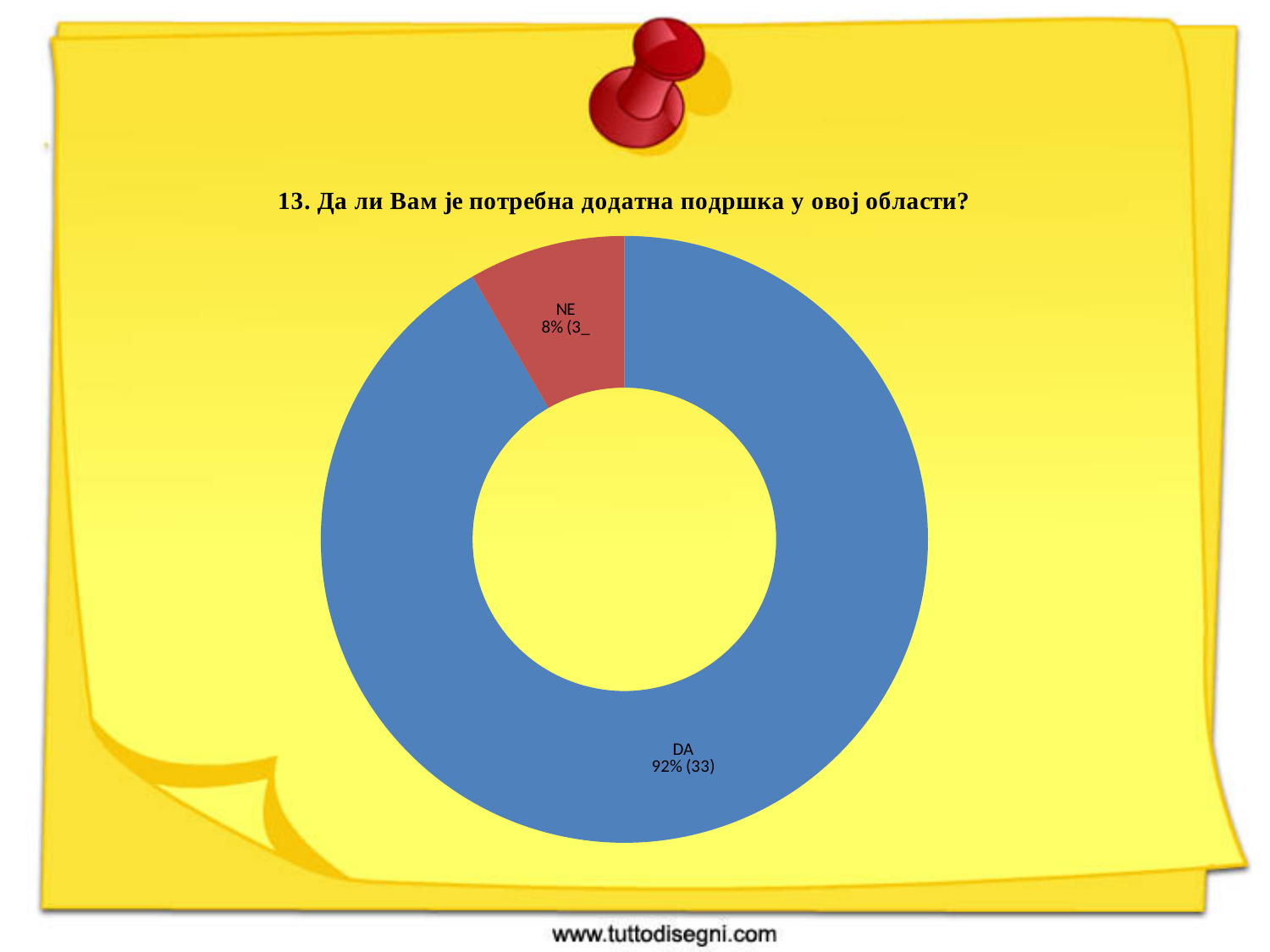
What colour is the DA slice? Blue How many respondents answered DA, according to the data label? 33 What kind of chart is shown on the slide? Doughnut (pie) chart What share of the chart does the DA slice represent? 92% What percentage of respondents answered NE? 8% Which answer has the largest share of the chart? DA What is the title of the chart? 13. Да ли Вам је потребна додатна подршка у овој области? How many categories are shown in the chart? 2 What is the difference in percentage points between the DA and NE shares? 84 percentage points What percentage of respondents answered DA? 92% Which is larger, the share for DA or the share for NE? DA Which answer has the smallest share of the chart? NE